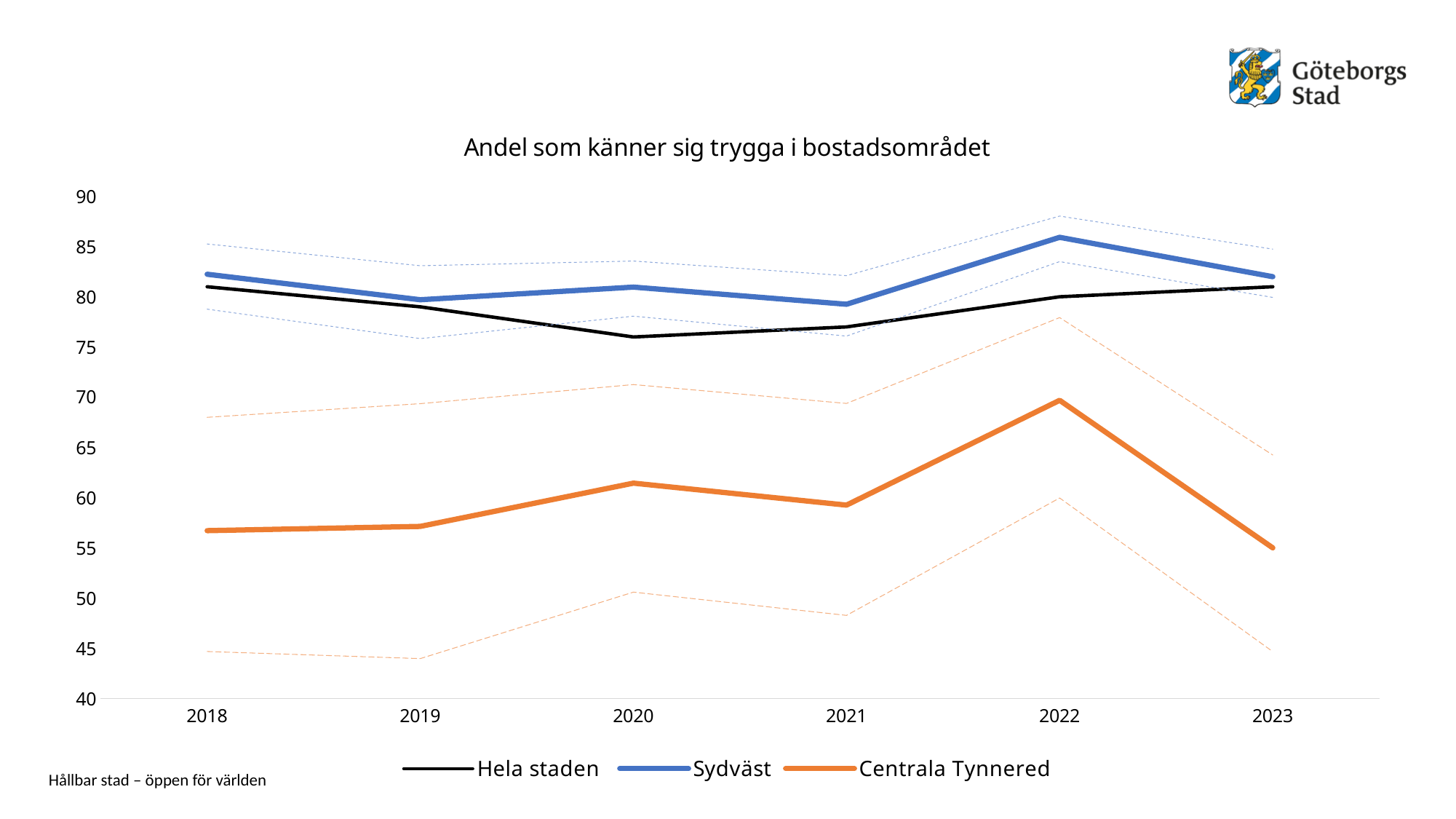
Is the value for Hela staden in 2020 greater or less than 80? less In which year is the value for Sydväst highest? 2022 Is the value for Centrala Tynnered in 2022 greater or less than 65? greater In which year is the value for Centrala Tynnered highest? 2022 How many series does the legend list? 3 Does the value for Centrala Tynnered rise or fall from 2022 to 2023? fall What colour is the line for Centrala Tynnered? orange In 2022, which is larger: Sydväst or Hela staden? Sydväst What is the title of the chart? Andel som känner sig trygga i bostadsområdet How many years are shown on the x axis? 6 What kind of chart is shown on the slide? line chart In which year is the value for Centrala Tynnered lowest? 2023